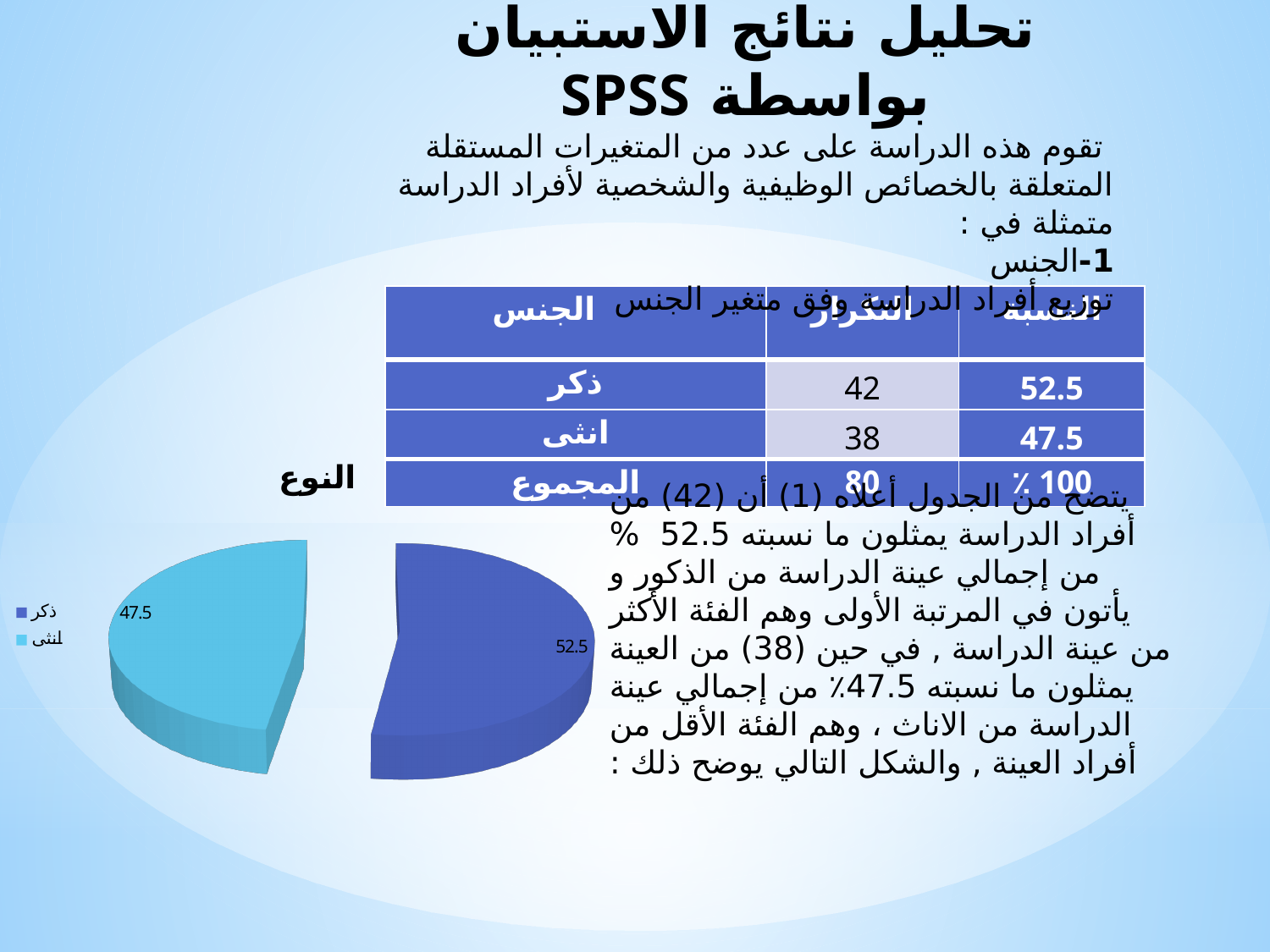
What is the total of the two values shown in the pie chart? 100 What is the title of the pie chart? النوع What value is shown for the ذكر slice of the pie chart? 52.5 Which slice of the pie chart is the largest? ذكر What is the difference between the ذكر and انثى values in the pie chart? 5 How many entries does the pie chart legend list? 2 Which is larger in the pie chart, ذكر or انثى? ذكر What value is shown for the انثى slice of the pie chart? 47.5 What colour is the ذكر slice in the pie chart? dark blue What kind of chart is shown on the slide? pie chart Which slice of the pie chart is the smallest? انثى How many slices does the pie chart have? 2